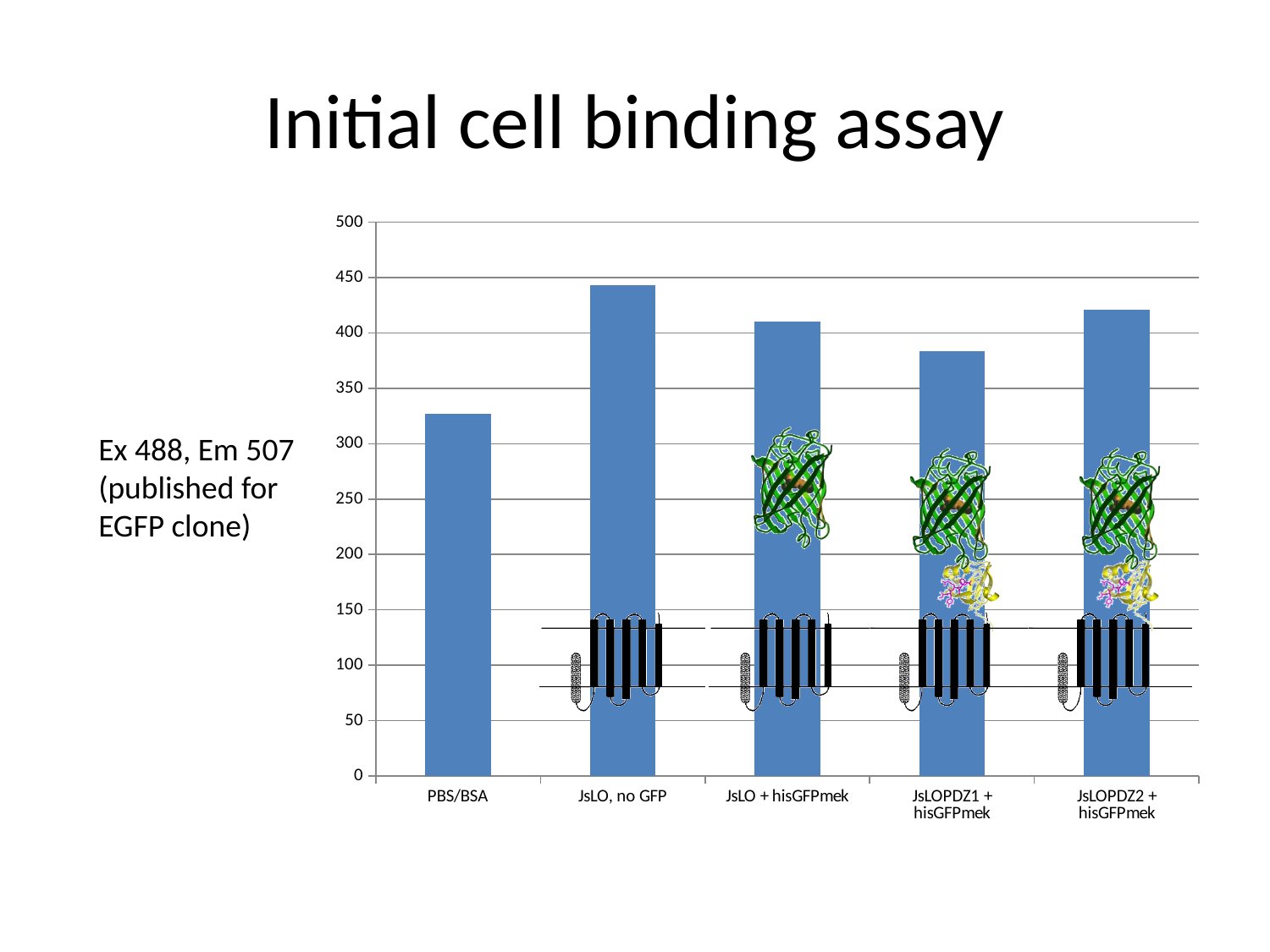
Which category has the lowest bar in the chart? PBS/BSA Is the value for JsLOPDZ1 + hisGFPmek greater or less than 400? less What is the title of the slide containing the chart? Initial cell binding assay Which is larger, the value for JsLO, no GFP or the value for JsLOPDZ1 + hisGFPmek? JsLO, no GFP Which category has the highest bar in the chart? JsLO, no GFP Which is larger, the value for PBS/BSA or the value for JsLOPDZ2 + hisGFPmek? JsLOPDZ2 + hisGFPmek Is the value for JsLO + hisGFPmek greater or less than 450? less Is the value for JsLO, no GFP greater or less than 400? greater How many categories are plotted on the x axis of the chart? 5 What kind of chart is shown on the slide? bar chart